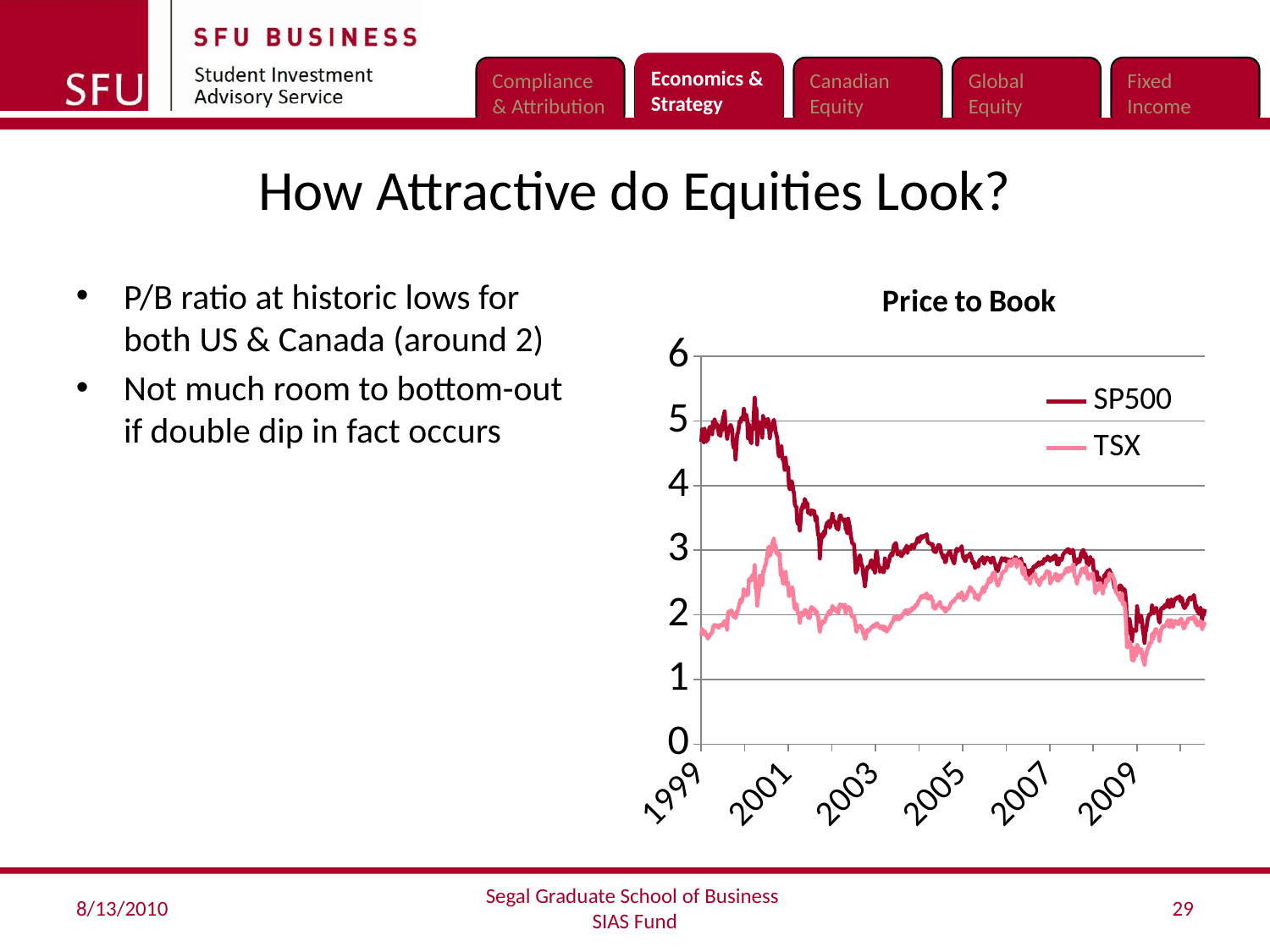
Which two series are listed in the chart's legend? SP500 and TSX Does the SP500 price-to-book ratio generally rise or fall from 1999 to 2009? fall What is the title of the chart? Price to Book Is the TSX value at the start of the series in 1999 greater or less than 2? less Which series has the higher price-to-book value in 1999, SP500 or TSX? SP500 Is the SP500 value at the start of the series in 1999 greater or less than 4? greater How many series does the chart's legend list? 2 How many year labels are shown on the x axis? 6 What kind of chart is shown on the slide? line chart What is the highest value shown on the y axis? 6 Is the highest TSX value on the chart greater or less than 4? less